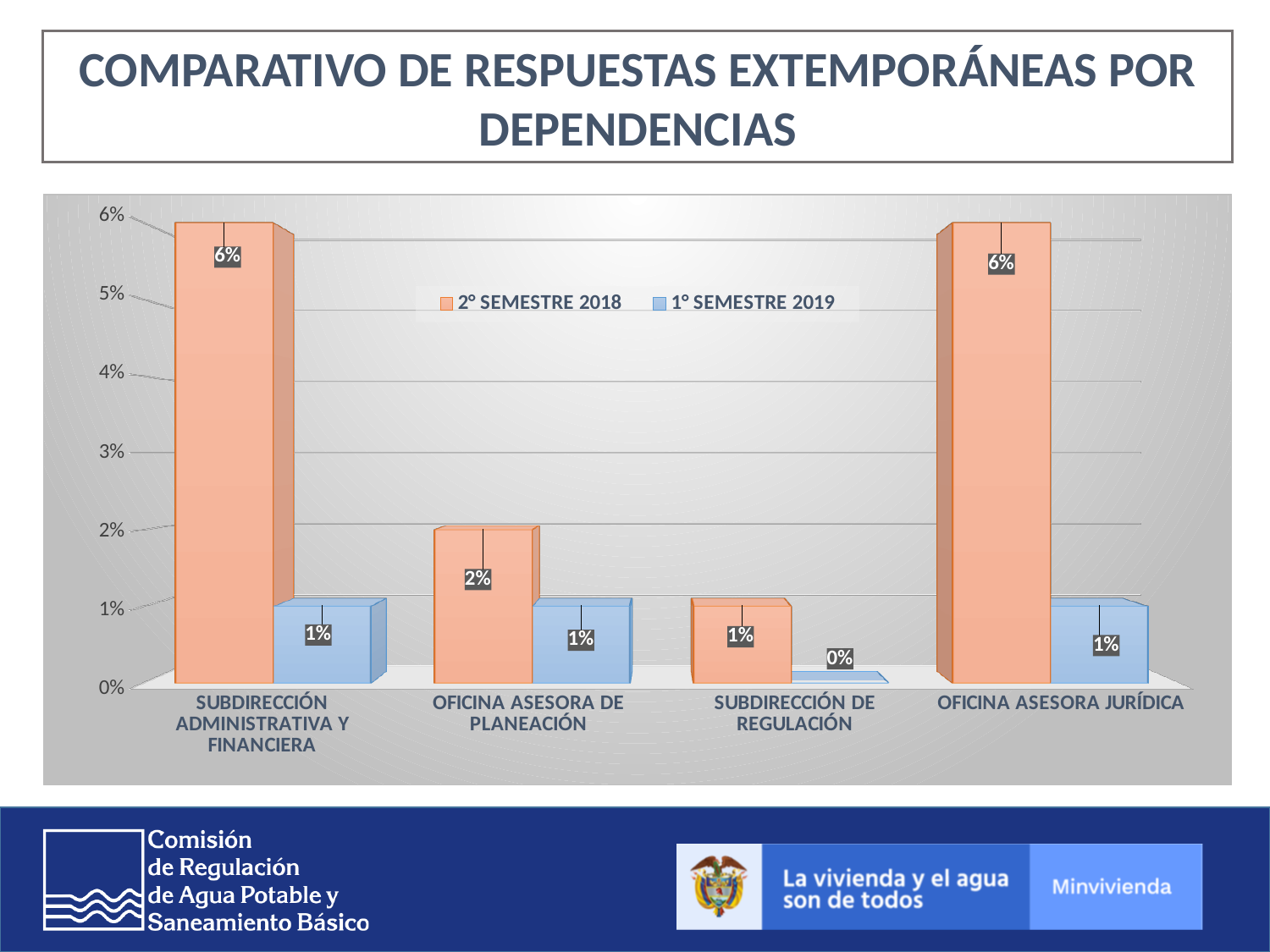
What is the difference between the 2° Semestre 2018 and 1° Semestre 2019 values for Subdirección Administrativa y Financiera? 5% What is the value for Oficina Asesora Jurídica in 2° Semestre 2018? 6% What kind of chart is shown on the slide? Bar chart What is the value for Subdirección de Regulación in 1° Semestre 2019? 0% Which is larger for Oficina Asesora de Planeación: the 2° Semestre 2018 value or the 1° Semestre 2019 value? 2° Semestre 2018 What is the title of the chart on the slide? Comparativo de respuestas extemporáneas por dependencias Which dependency has the lowest value in 1° Semestre 2019? Subdirección de Regulación Which dependency has the lowest value in 2° Semestre 2018? Subdirección de Regulación What is the value for Subdirección Administrativa y Financiera in 1° Semestre 2019? 1% How many dependencies (categories) are shown on the x axis? 4 How many series does the legend list? 2 What is the value for Oficina Asesora de Planeación in 2° Semestre 2018? 2%